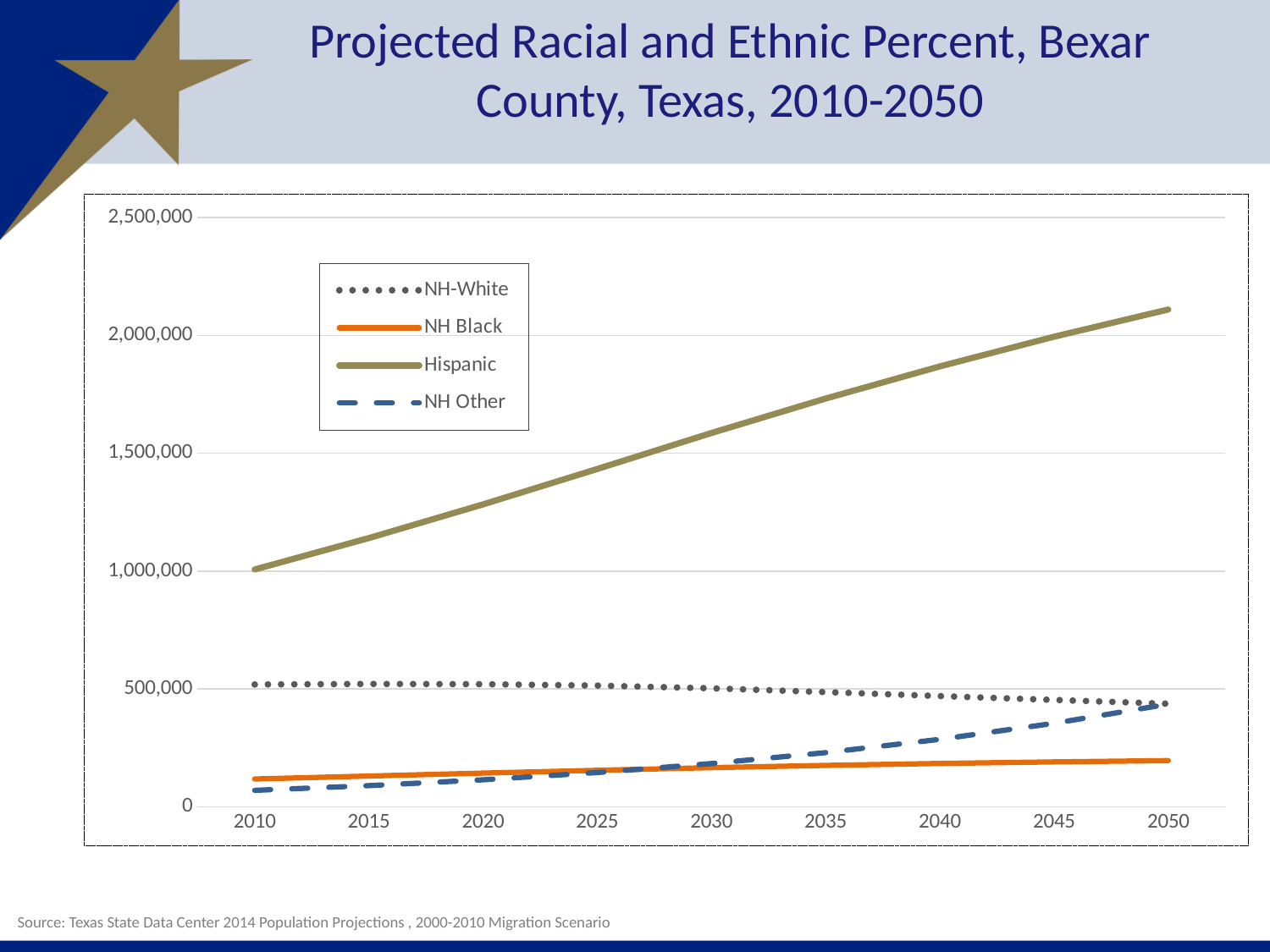
What kind of chart is shown on the slide? line chart Which is larger in 2010, the NH-White value or the Hispanic value? Hispanic Which series has the lowest value in 2010? NH Other Which series is drawn with a dotted line in the legend? NH-White Is the NH Black value in 2050 greater or less than 500,000? less Does the Hispanic series rise or fall from 2010 to 2050? rise Does the NH-White series rise or fall from 2010 to 2050? fall Is the Hispanic value in 2010 greater or less than 1,500,000? less Is the Hispanic value in 2050 greater or less than 2,000,000? greater How many series does the legend list? 4 Which is larger in 2040, the NH Other value or the NH Black value? NH Other Which series has the highest value in 2050? Hispanic